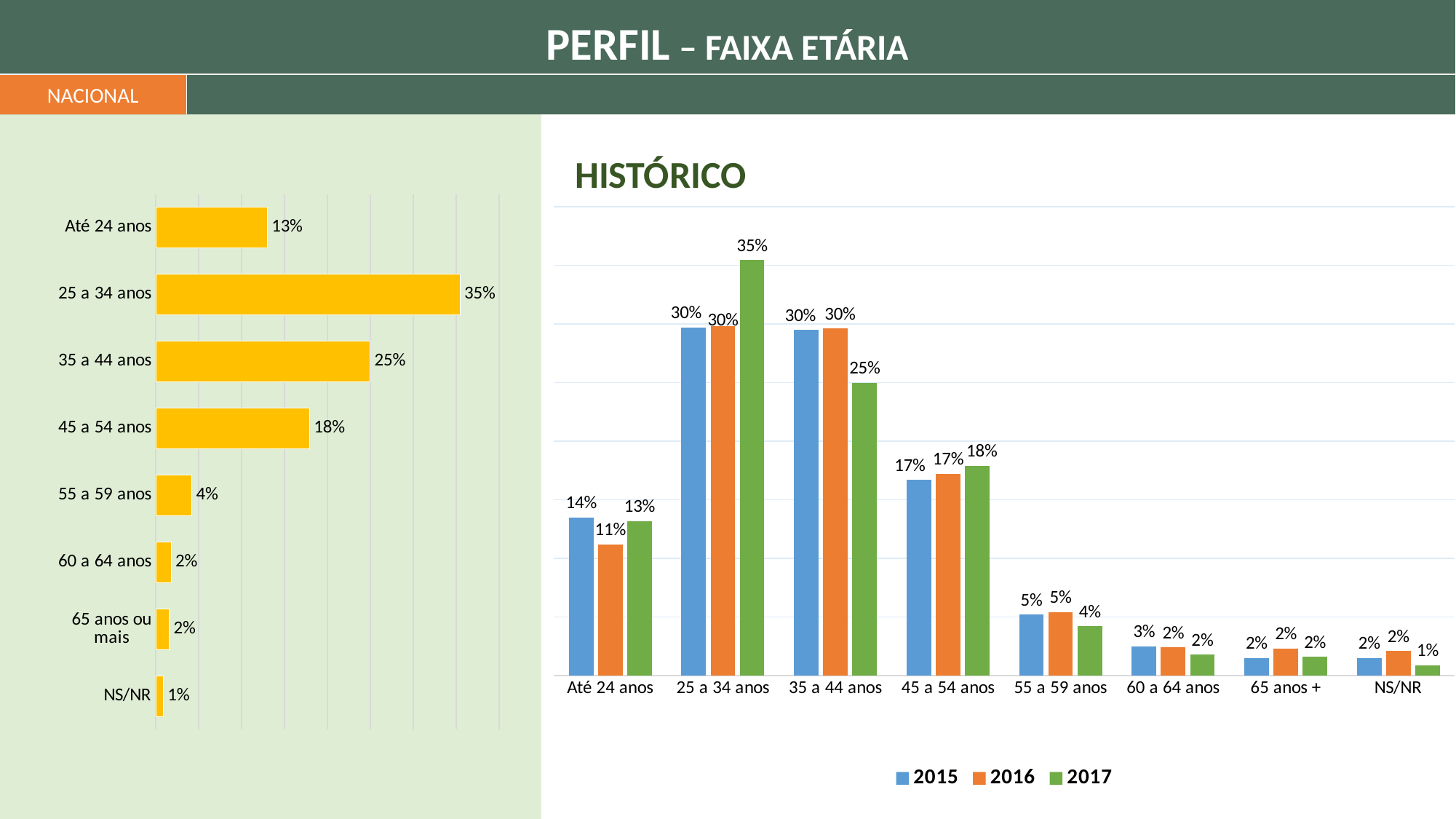
In the HISTÓRICO chart, which colour represents 2017? Green In the HISTÓRICO chart, how many series does the legend list? 3 In the left-hand bar chart, which age group has the highest value? 25 a 34 anos In the left-hand bar chart, what is the value for 25 a 34 anos? 35% In the left-hand bar chart, which category has the lowest value? NS/NR In the HISTÓRICO chart, which is larger for 35 a 44 anos: the 2015 value or the 2017 value? 2015 In the HISTÓRICO chart, what is the 2016 value for Até 24 anos? 11% What kind of chart is the HISTÓRICO chart? Bar chart In the left-hand bar chart, what is the difference between 35 a 44 anos and 45 a 54 anos? 7% In the HISTÓRICO chart, what is the 2017 value for 45 a 54 anos? 18% In the HISTÓRICO chart, what is the difference between the 2017 and 2015 values for 25 a 34 anos? 5% In the left-hand bar chart, how many categories are shown? 8